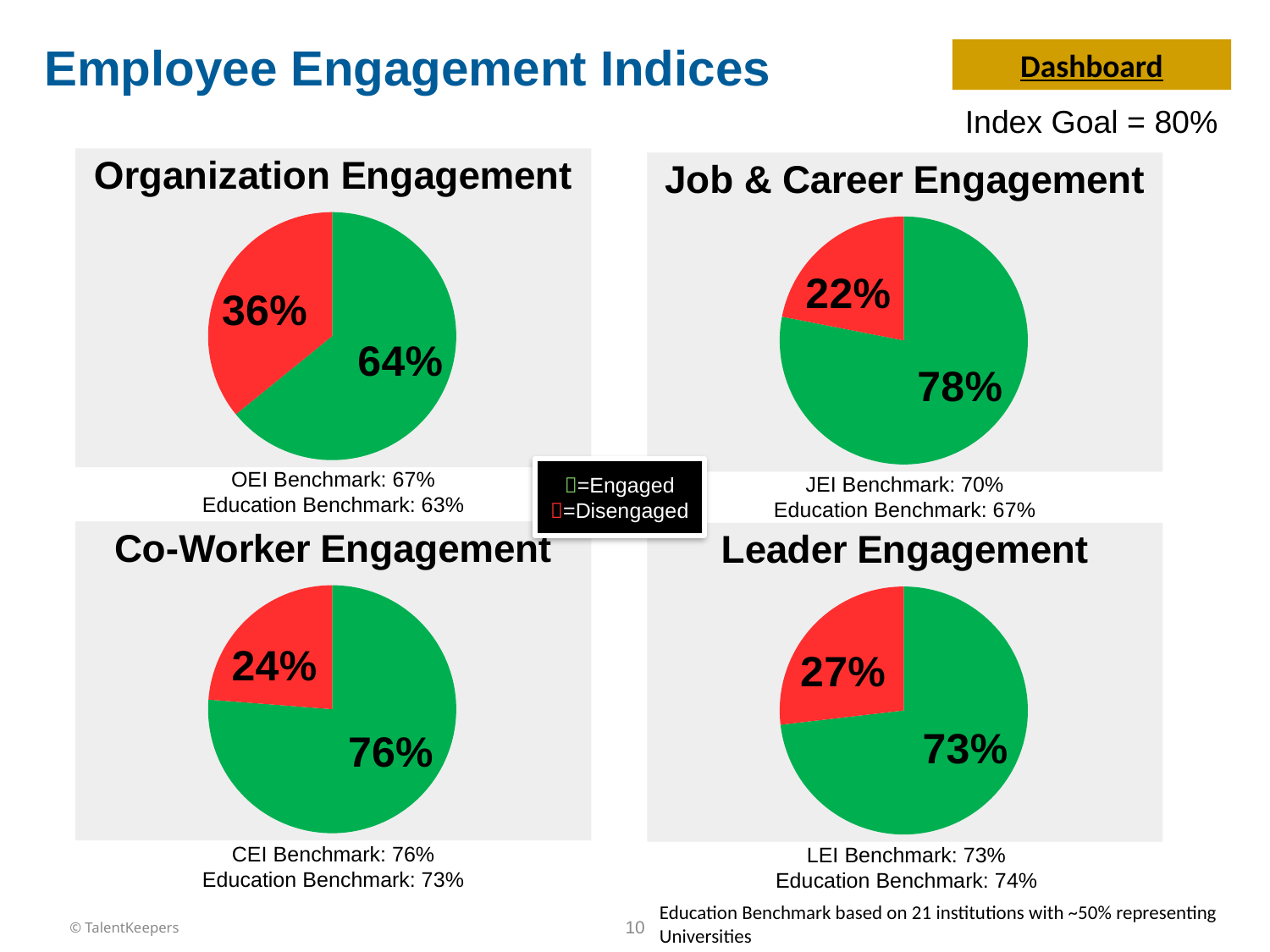
Which of the four pie charts shows the highest Engaged percentage? Job & Career Engagement In the Organization Engagement chart, what percentage is shown for the Engaged (green) slice? 64% In the Leader Engagement chart, what percentage is shown for the Disengaged (red) slice? 27% According to the legend, what does the green colour represent? Engaged In the Job & Career Engagement chart, what percentage is shown for the Disengaged (red) slice? 22% What kind of chart is used for Organization Engagement? Pie chart How many slices does the Leader Engagement pie chart have? 2 In the Organization Engagement chart, which slice is larger, Engaged or Disengaged? Engaged In the Co-Worker Engagement chart, what percentage is shown for the Engaged (green) slice? 76% In the Organization Engagement chart, what is the difference between the Engaged and Disengaged percentages? 28% In the Job & Career Engagement chart, what is the difference between the Engaged and Disengaged percentages? 56% Which of the four pie charts shows the lowest Engaged percentage? Organization Engagement